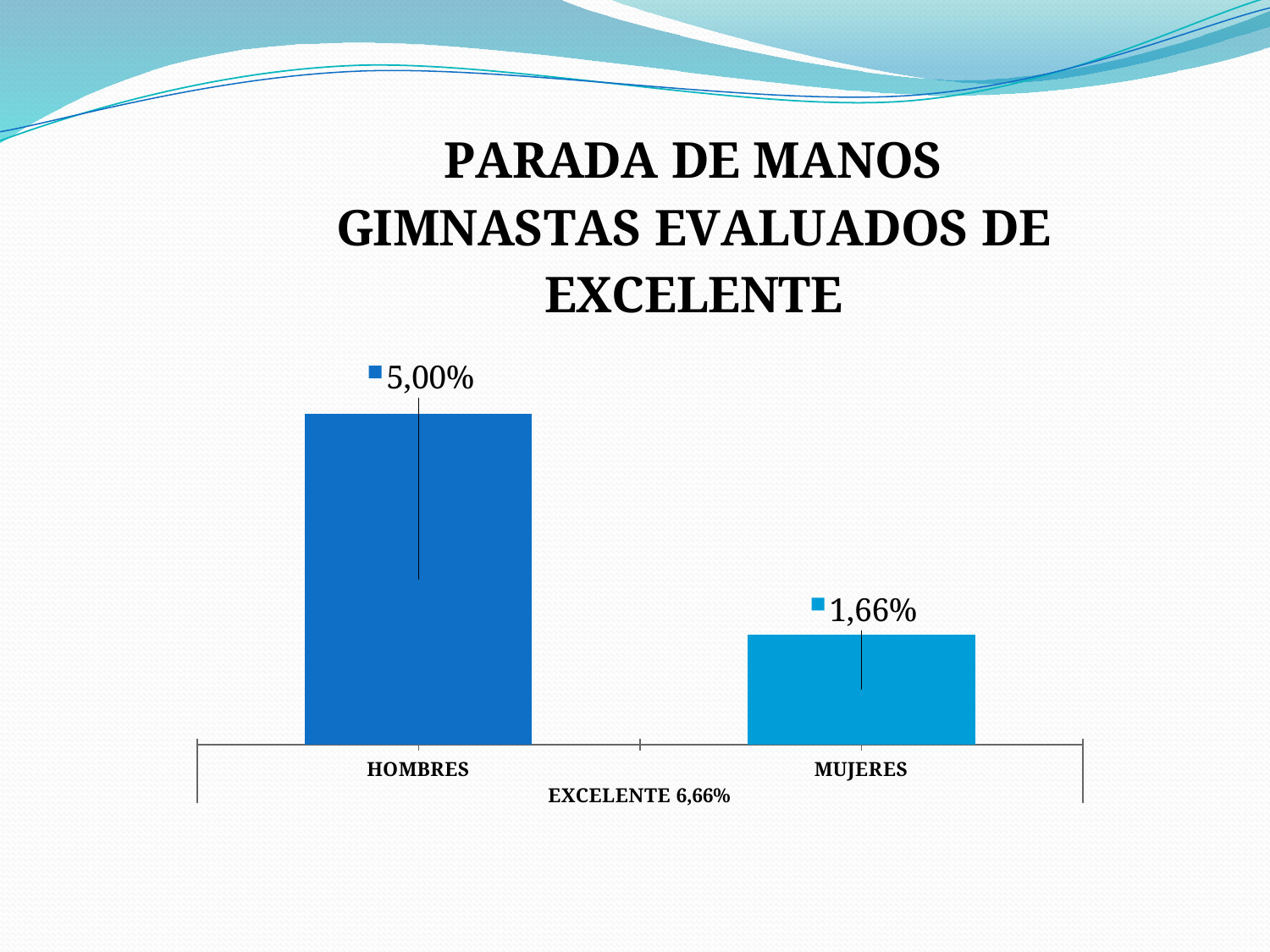
Which is larger, the value for HOMBRES or the value for MUJERES? HOMBRES What label appears below the category axis? EXCELENTE 6,66% Which category has the highest value? HOMBRES What is the value for MUJERES? 1,66% Which category has the lowest value? MUJERES What is the title of the chart? PARADA DE MANOS GIMNASTAS EVALUADOS DE EXCELENTE What is the total of the values for HOMBRES and MUJERES? 6,66% What is the value for HOMBRES? 5,00% How many categories are shown on the x axis? 2 Do the values rise or fall from HOMBRES to MUJERES? Fall What kind of chart is shown on the slide? Bar chart What is the difference between the values for HOMBRES and MUJERES? 3,34%